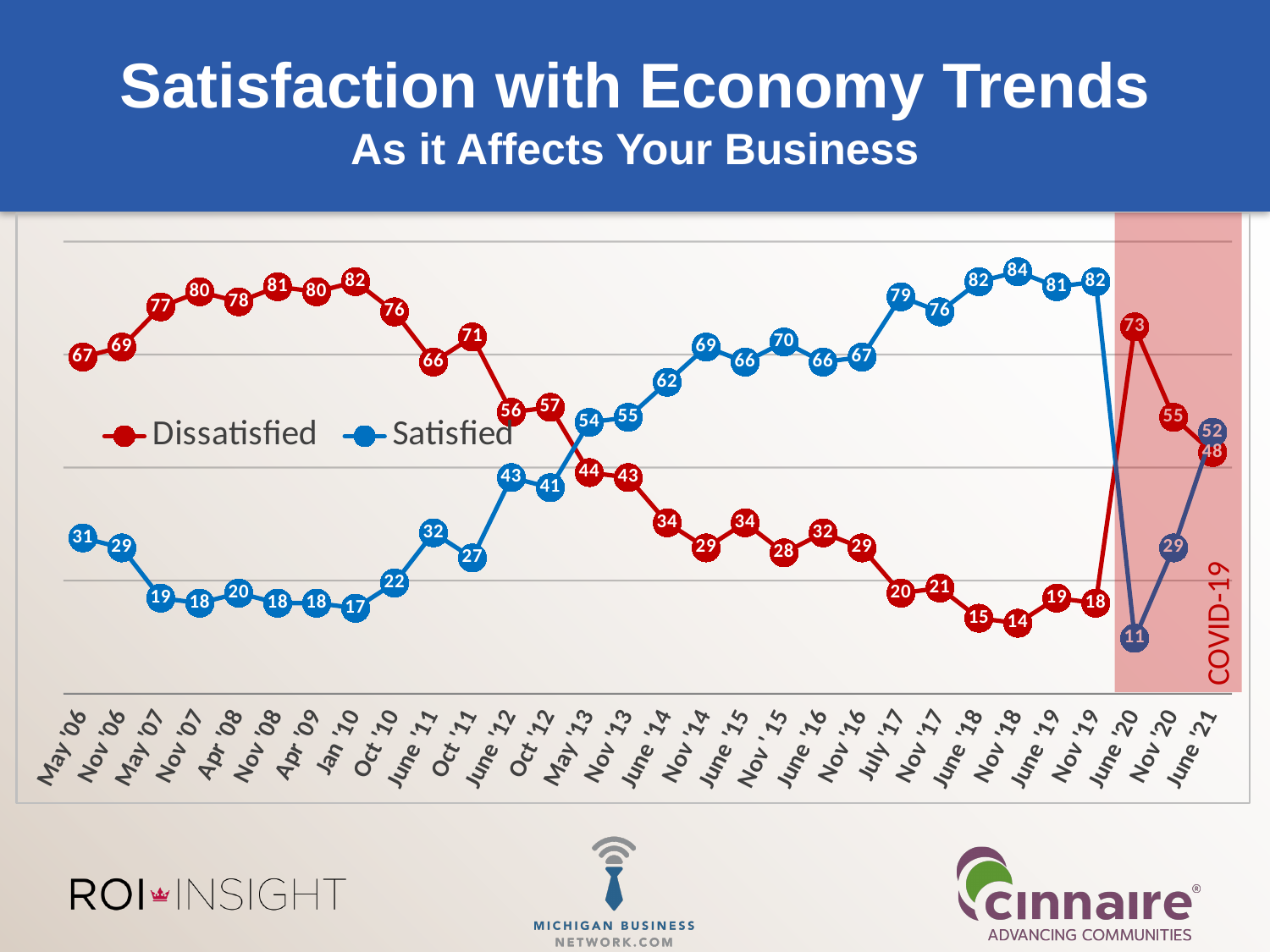
What kind of chart is shown on the slide? Line chart In which period does the Dissatisfied series reach its lowest value? Nov '18 What is the Dissatisfied value for June '20? 73 How many time periods are shown on the x axis? 30 What is the Dissatisfied value for May '06? 67 What is the difference between the Satisfied and Dissatisfied values in June '21? 4 What label is written in the shaded region at the right of the chart? COVID-19 In which period does the Satisfied series reach its highest value? Nov '18 How many series does the legend list? 2 Between Jan '10 and Nov '18, does the Dissatisfied line generally rise or fall? Fall In Nov '19, which series has the larger value, Satisfied or Dissatisfied? Satisfied What is the Satisfied value for June '20? 11